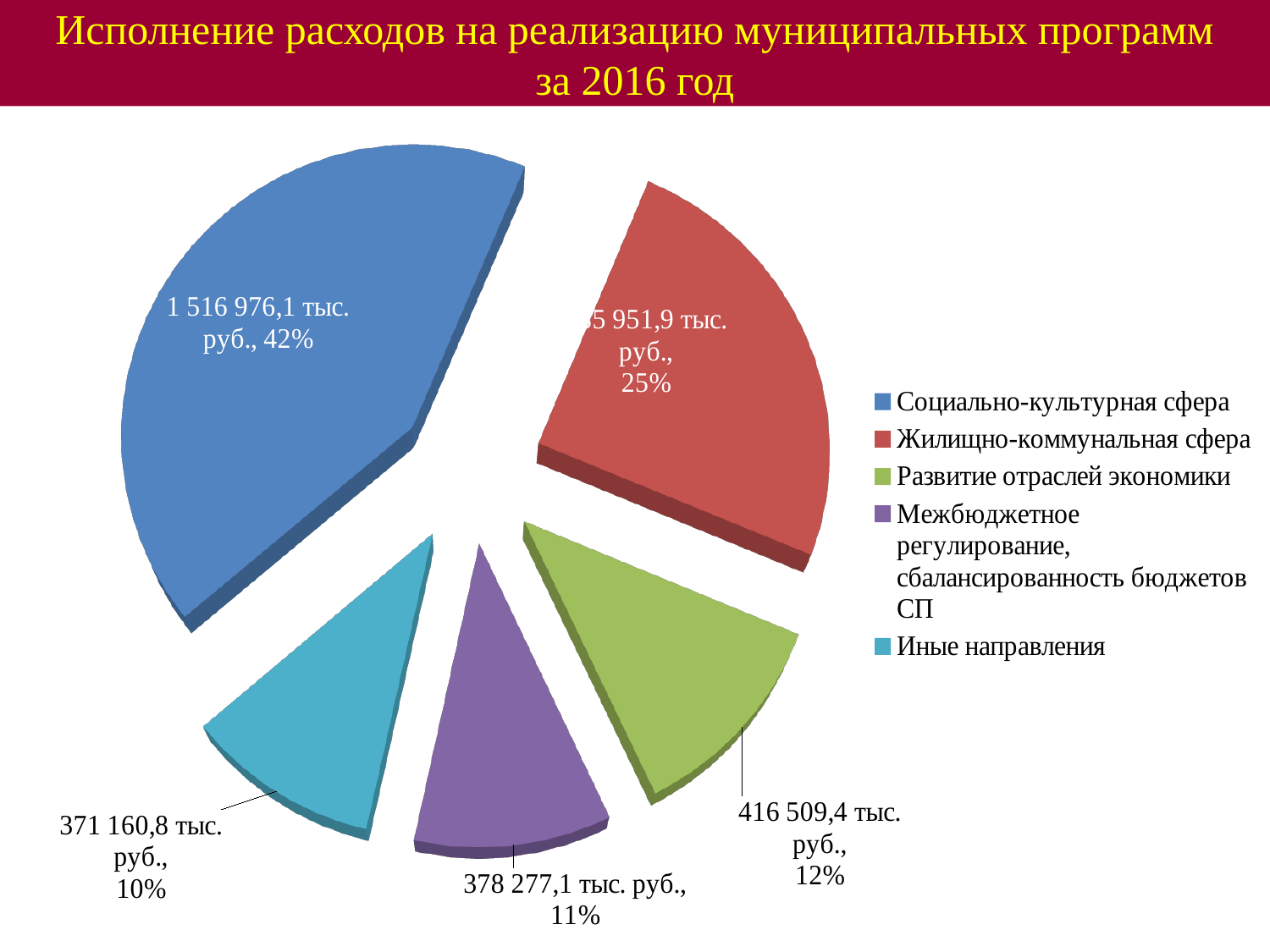
What is the value for Развитие отраслей экономики? 416 509,4 тыс. руб. What kind of chart is shown on the slide? Pie chart What is the title of the chart on the slide? Исполнение расходов на реализацию муниципальных программ за 2016 год What is the value for Социально-культурная сфера? 1 516 976,1 тыс. руб. Which category has the largest share of the pie? Социально-культурная сфера Which category has the smallest share of the pie? Иные направления What is the value for Иные направления? 371 160,8 тыс. руб. What share of the pie does Межбюджетное регулирование, сбалансированность бюджетов СП take? 11% Which is larger, the value for Развитие отраслей экономики or the value for Иные направления? Развитие отраслей экономики How many slices does the pie chart have? 5 What share of the pie does Жилищно-коммунальная сфера take? 25% How many entries does the legend list? 5